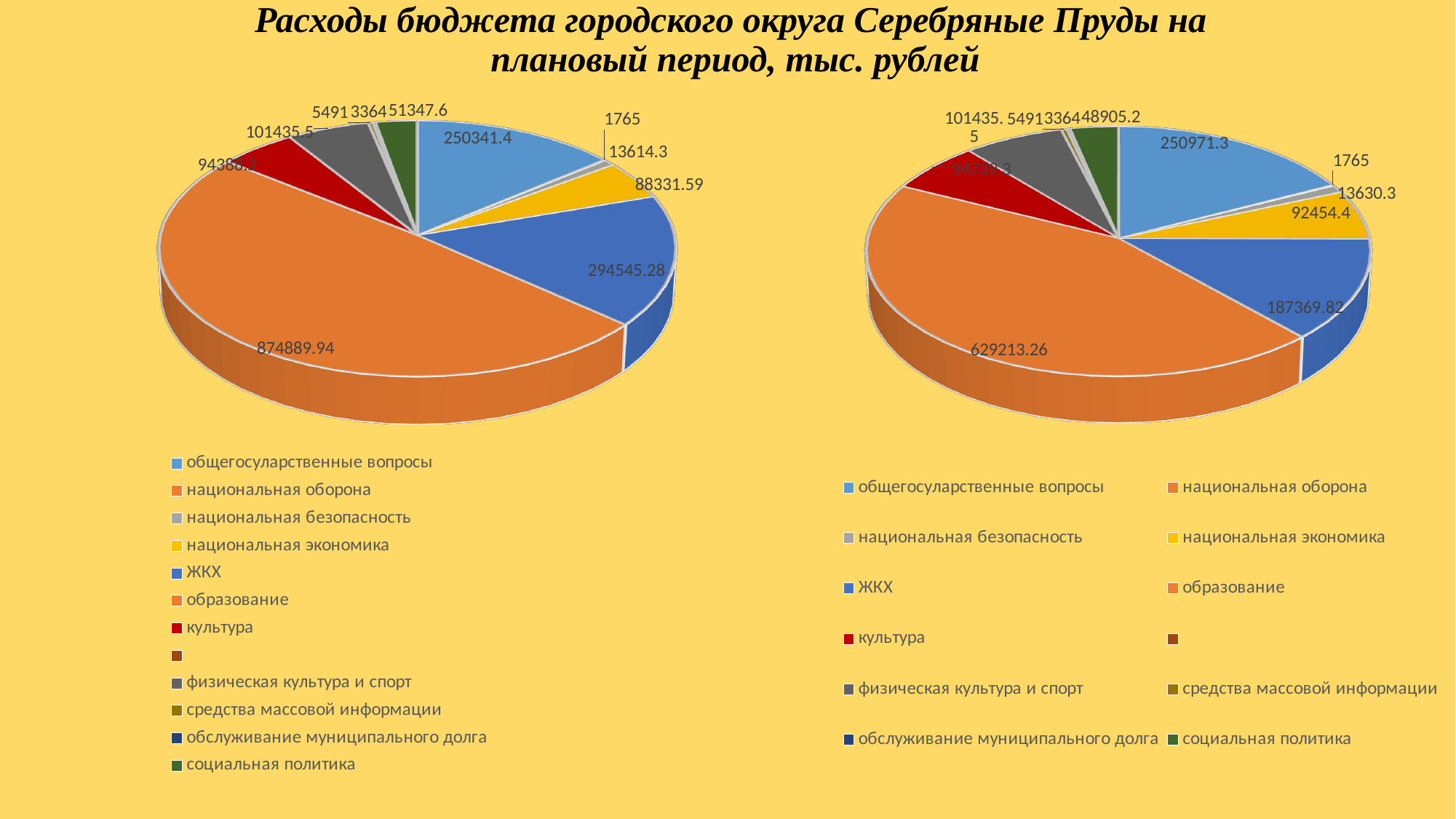
In the left pie chart, what is the value for образование? 874889.94 In the right pie chart, what is the value for ЖКХ? 187369.82 Is the value for ЖКХ larger in the left pie chart or the right pie chart? left What colour is the образование slice in both pie charts? orange In the right pie chart, which category has the largest slice? образование What is the difference between the образование value in the left pie chart and in the right pie chart? 245676.68 In the right pie chart, what is the value for общегосударственные вопросы? 250971.3 What kind of chart is shown on the left of the slide? pie chart In the left pie chart, what is the value for ЖКХ? 294545.28 In the right pie chart, what is the value for образование? 629213.26 In the left pie chart, which category has the largest slice? образование In the right pie chart, what is the value for национальная экономика? 92454.4